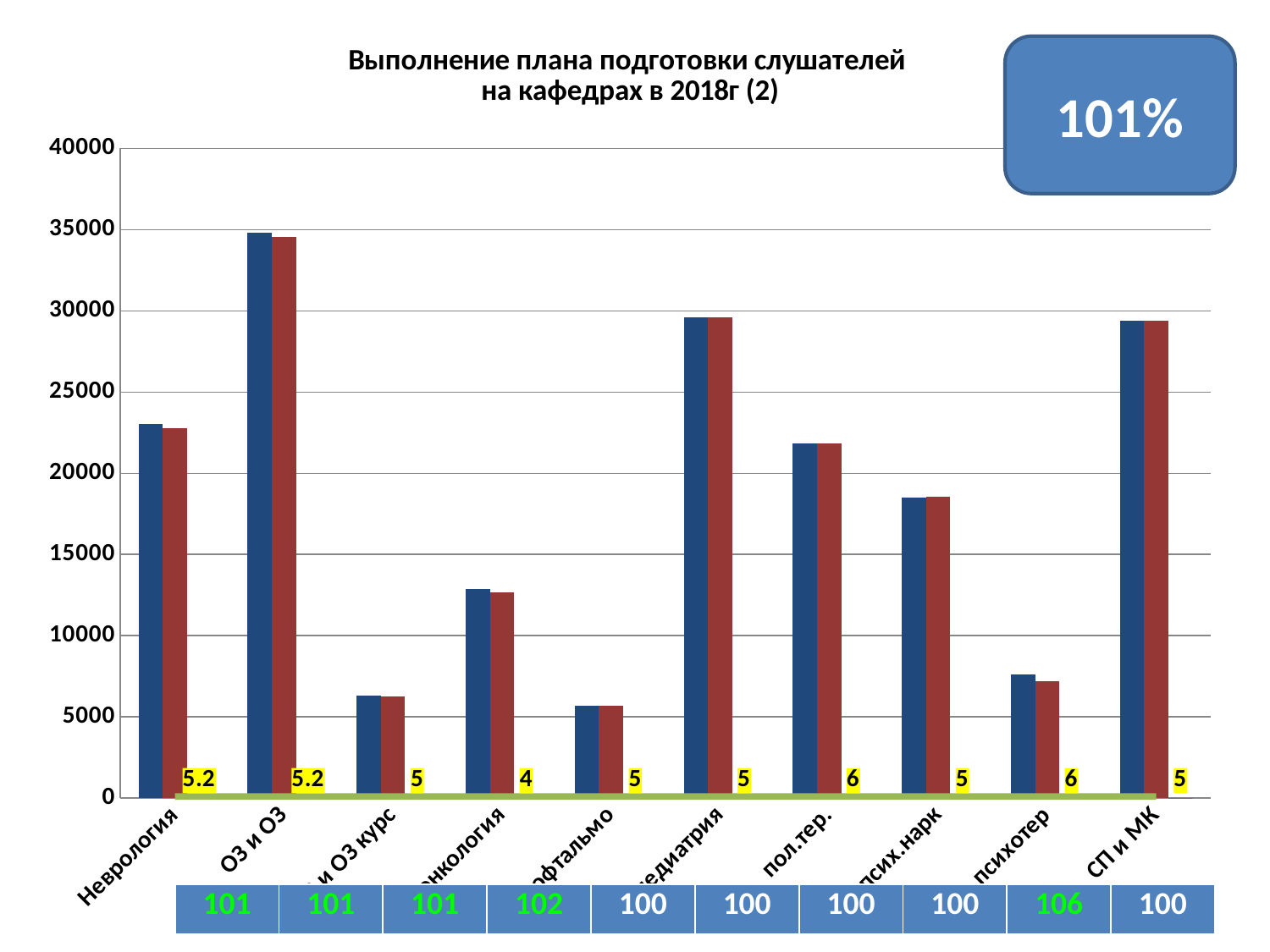
How many categories are shown along the x axis of the chart? 10 Is the value of the blue bar for психотер greater or less than 10000? less What is the title of the chart? Выполнение плана подготовки слушателей на кафедрах в 2018г (2) What type of chart is shown on the slide? bar chart What is the data label shown on the green line for СП и МК? 5 Is the value of the blue bar for СП и МК greater or less than 25000? greater What is the data label shown on the green line for Неврология? 5.2 What is the data label shown on the green line for пол.тер.? 6 Which category has the tallest bars in the chart? ОЗ и ОЗ Which has taller bars, Неврология or СП и МК? СП и МК Is the value of the blue bar for Неврология greater or less than 20000? greater What percentage is shown in the rounded box in the top right corner of the slide? 101%